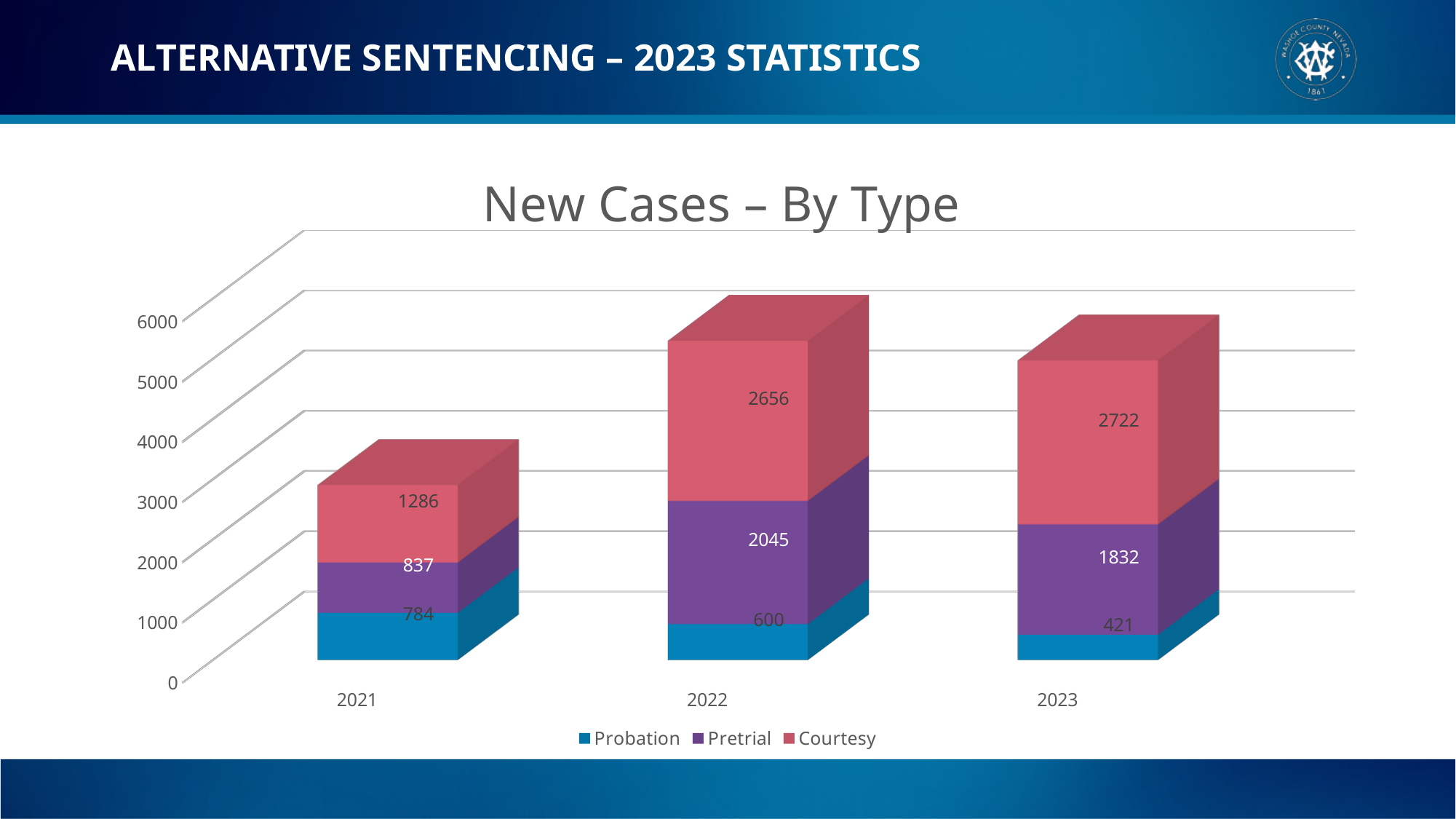
Which year has the highest Pretrial value? 2022 How many years are shown on the x axis? 3 What is the difference between the Courtesy values for 2023 and 2021? 1436 Which year has the lowest Probation value? 2023 What is the Probation value for 2023? 421 What is the Courtesy value for 2022? 2656 How many series does the legend list? 3 What is the Pretrial value for 2021? 837 What is the total of the stacked bar for 2021? 2907 What kind of chart is shown? Stacked bar chart What is the total of the stacked bar for 2022? 5301 Which is larger, the Pretrial value for 2023 or the Pretrial value for 2021? 2023